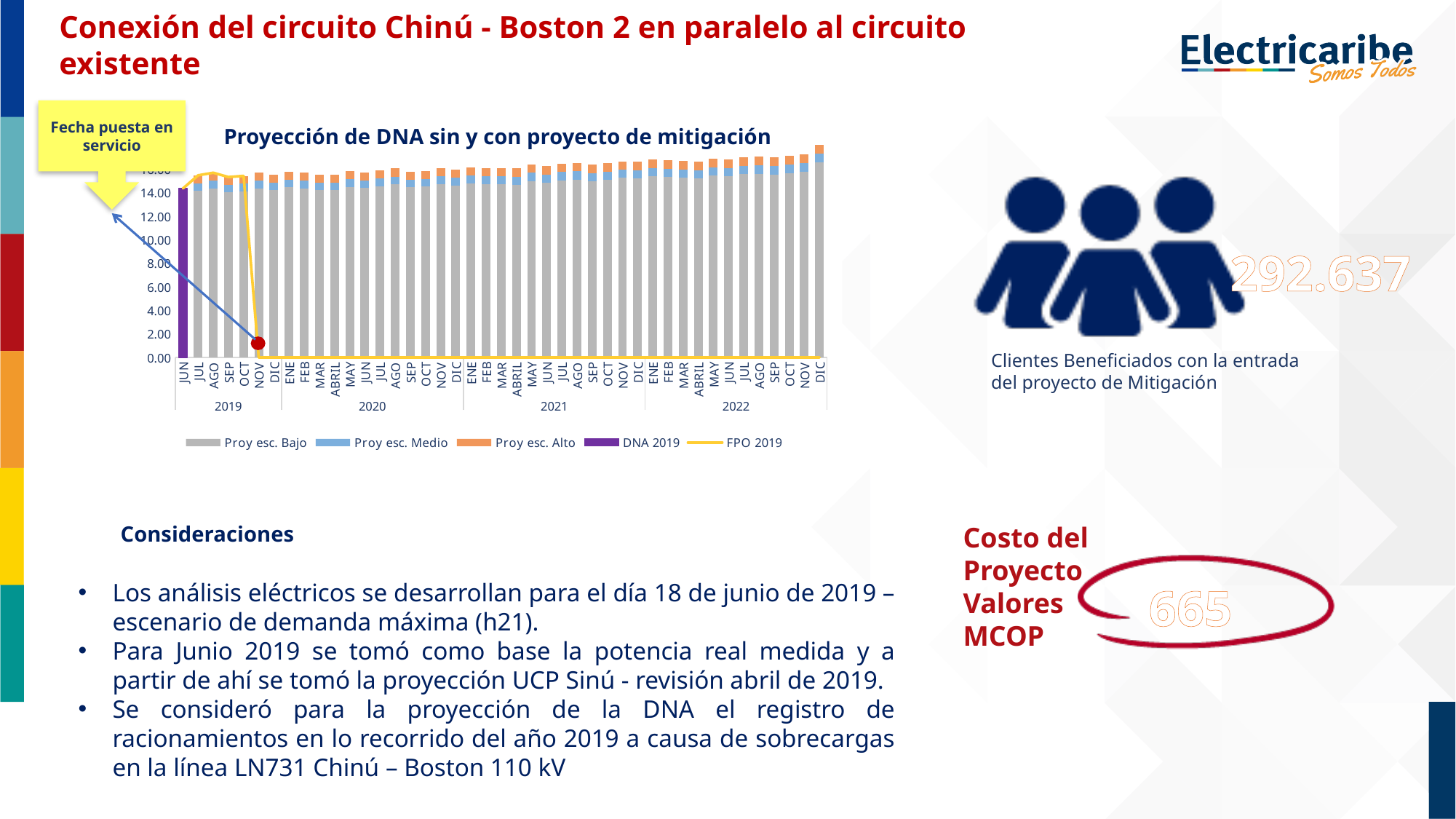
Is the FPO 2019 value for JUL 2019 greater or less than 14.00? greater Which month and year has the tallest stacked bar in the chart? DIC 2022 Do the stacked projection bars generally rise or fall from 2020 to 2022? Rise How many series does the legend of the chart list? 5 How many years are shown along the x axis of the chart? 4 Is the DNA 2019 bar for JUN 2019 greater or less than 12.00? greater Is the FPO 2019 value for NOV 2019 greater or less than 4.00? less How many months are plotted for the year 2019 in the chart? 7 Which series in the chart is drawn as a line rather than bars? FPO 2019 What colour are the 'Proy esc. Alto' bars in the chart? Orange Which is larger in the chart: the FPO 2019 value for OCT 2019 or for NOV 2019? OCT 2019 What kind of chart is shown under the title 'Proyección de DNA sin y con proyecto de mitigación'? Bar chart with a line